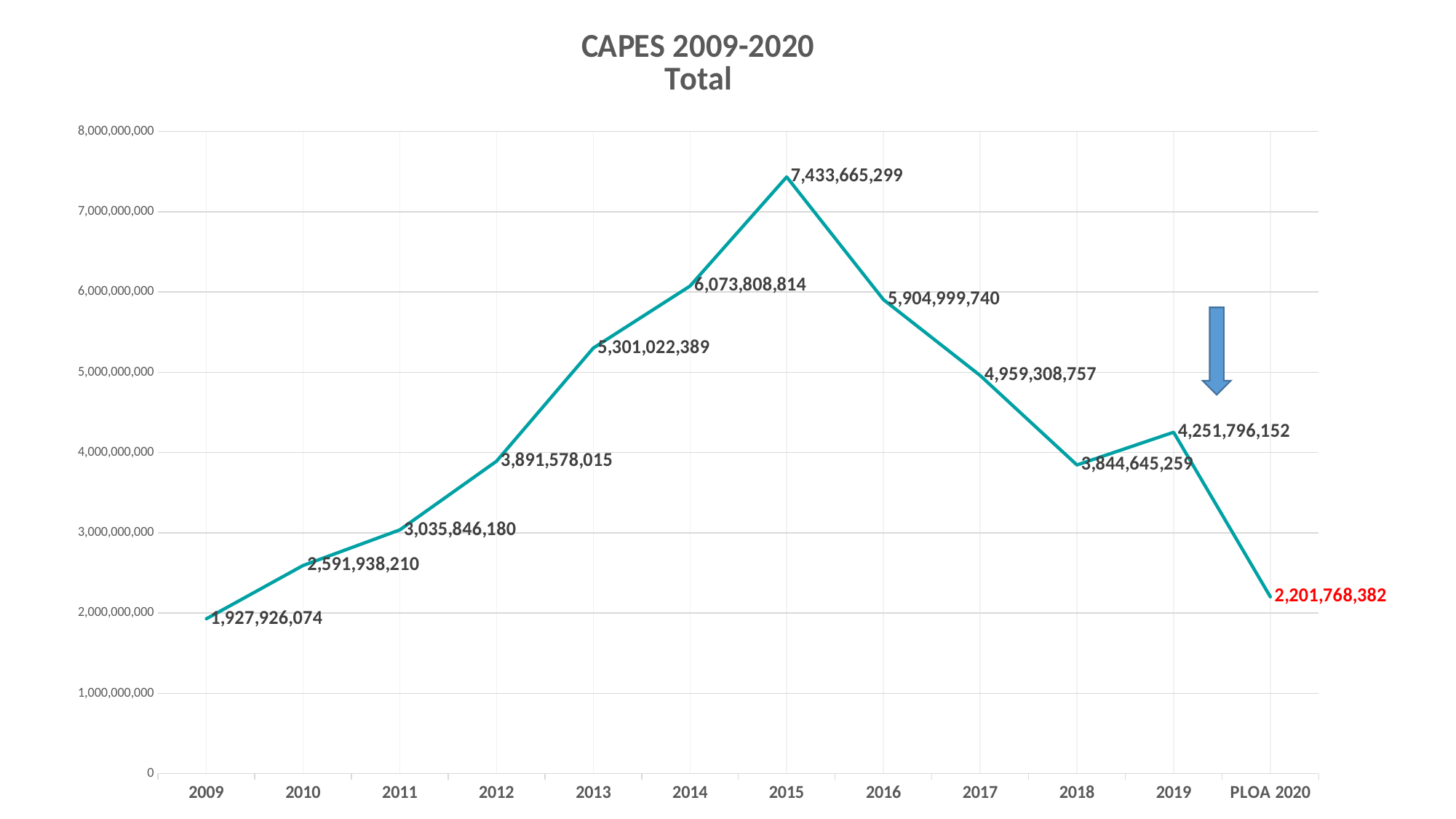
Is the value for 2013 greater or less than 5,000,000,000? greater How many data points are plotted on the chart? 12 What is the value for 2015? 7,433,665,299 How do the values change from 2015 to 2018? they fall Which year has the highest value? 2015 What is the difference between the values for 2019 and PLOA 2020? 2,050,027,770 What kind of chart is shown on the slide? line chart What is the value for 2012? 3,891,578,015 What is the value for PLOA 2020? 2,201,768,382 Which category has the lowest value? 2009 Which is larger, the value for 2014 or the value for 2016? 2014 What is the difference between the values for 2019 and 2018? 407,150,893